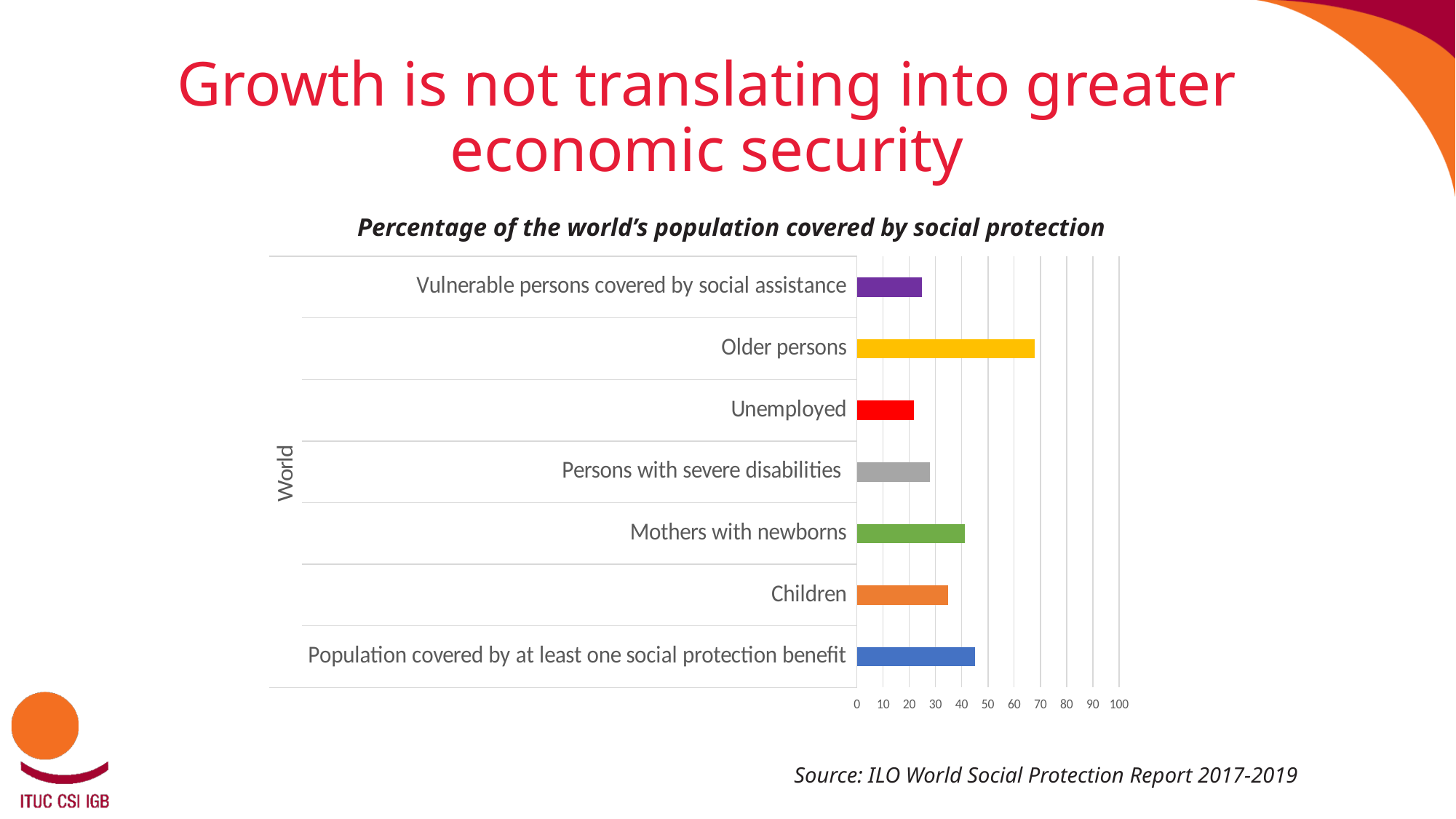
Is the value for Population covered by at least one social protection benefit greater or less than 40? greater Is the value for Vulnerable persons covered by social assistance greater or less than 30? less Which is larger, the value for Older persons or the value for Children? Older persons Is the value for Unemployed greater or less than 30? less Which is larger, the value for Mothers with newborns or the value for Children? Mothers with newborns What kind of chart is shown on the slide? Bar chart What is the title of the chart? Percentage of the world's population covered by social protection Which category has the highest percentage of the world's population covered by social protection? Older persons How many categories are plotted in the chart? 7